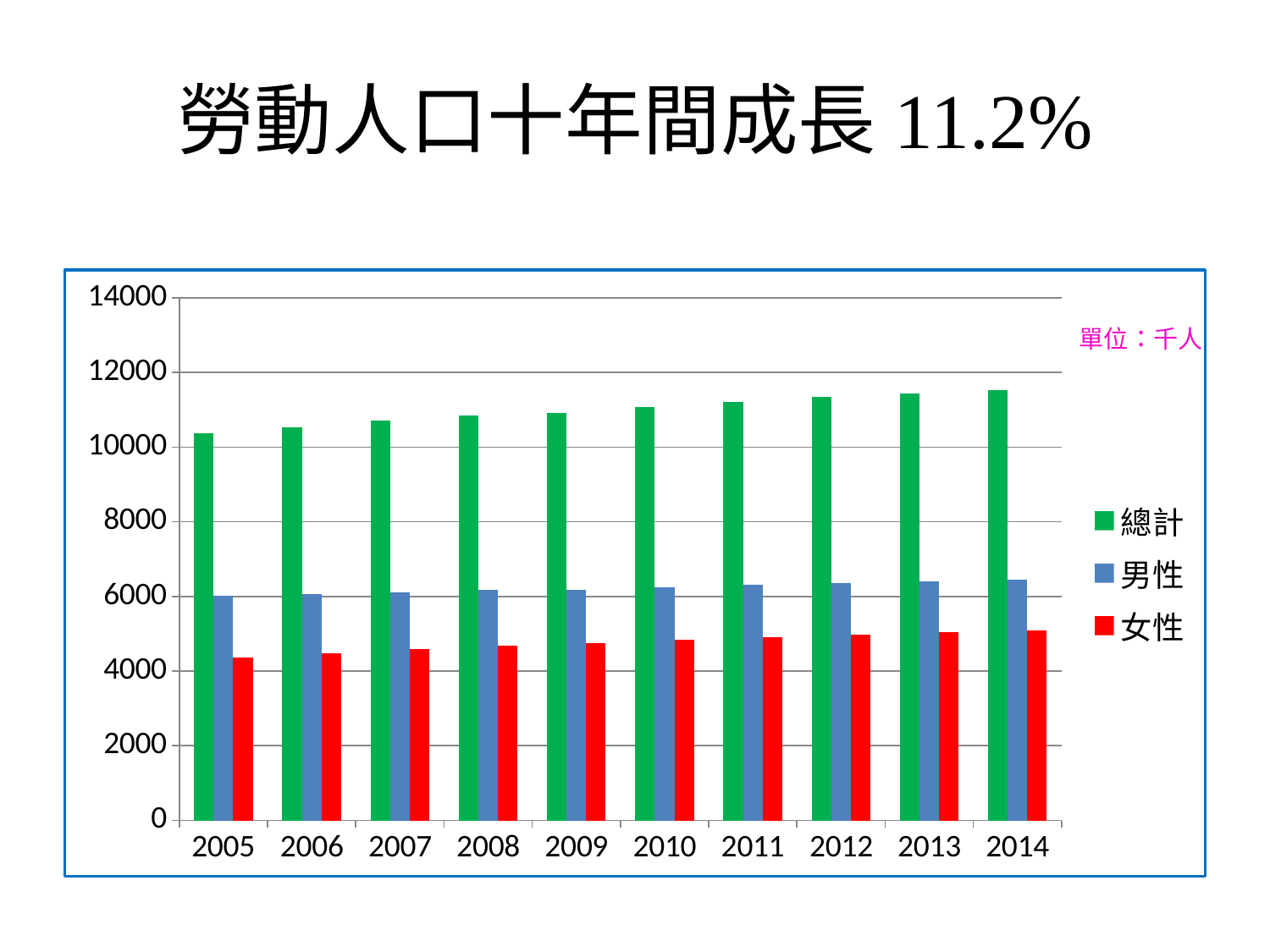
Is the value for 總計 in 2014 greater or less than 12000? less What unit is stated on the chart for the values? 千人 How many series does the chart's legend list? 3 Is the value for 女性 in 2014 greater or less than 4000? greater Is the value for 女性 in 2005 greater or less than 6000? less Which year has the highest value for 總計? 2014 Which year has the lowest value for 女性? 2005 What kind of chart is shown on the slide? bar chart How many years are shown along the x axis of the chart? 10 Do the values for 總計 rise or fall from 2005 to 2014? rise In 2010, which is larger, the value for 男性 or the value for 女性? 男性